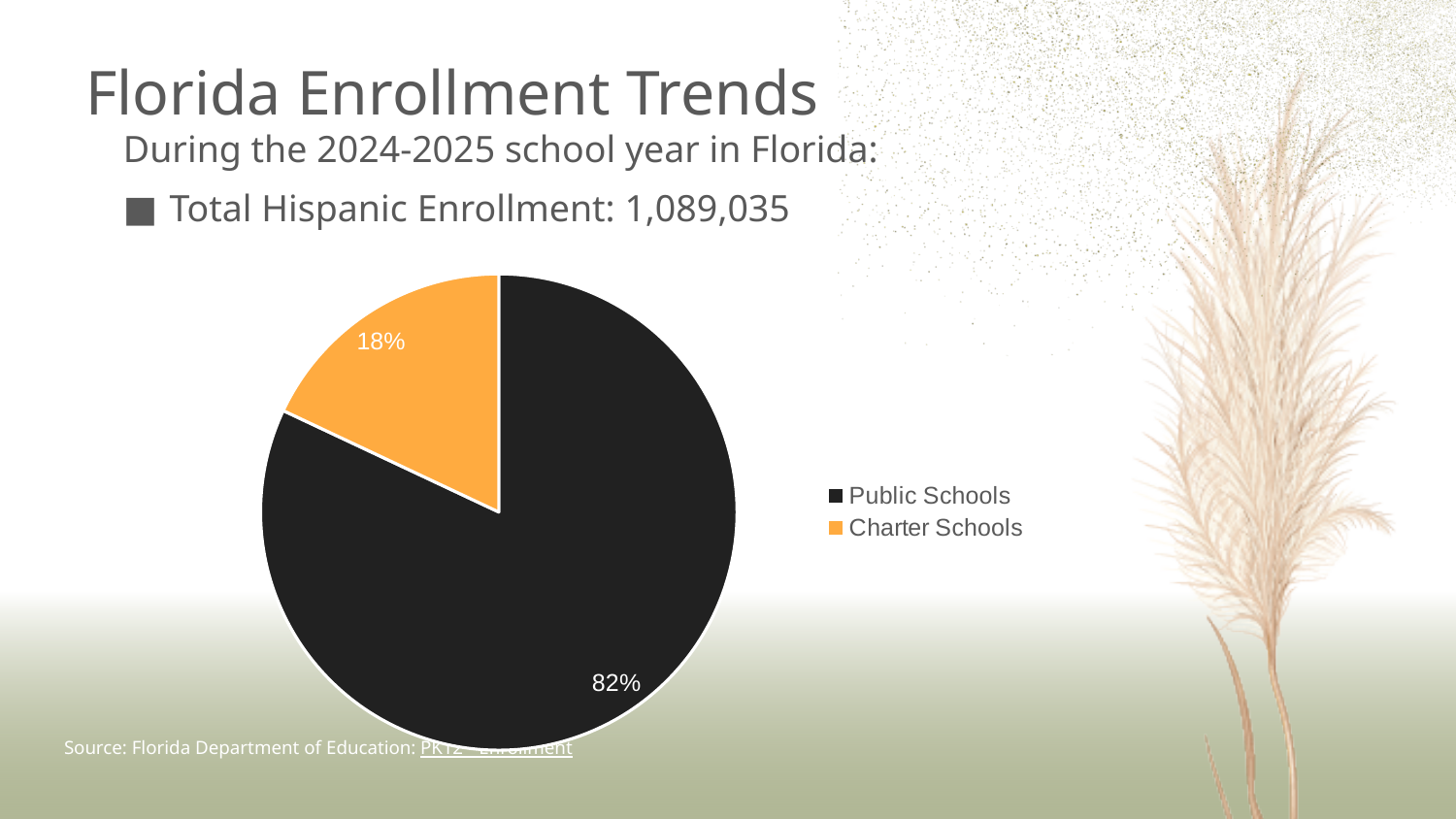
What kind of chart is shown on the slide? Pie chart What colour is the Charter Schools slice? Orange Which category has the largest slice of the pie? Public Schools Which category has the smallest slice of the pie? Charter Schools How many slices does the pie chart have? 2 What is the difference in percentage points between the Public Schools and Charter Schools slices? 64 Which is larger, the Public Schools slice or the Charter Schools slice? Public Schools What colour is the Public Schools slice? Black What share of the pie is Public Schools? 82% What share of the pie is Charter Schools? 18% How many entries does the legend list? 2